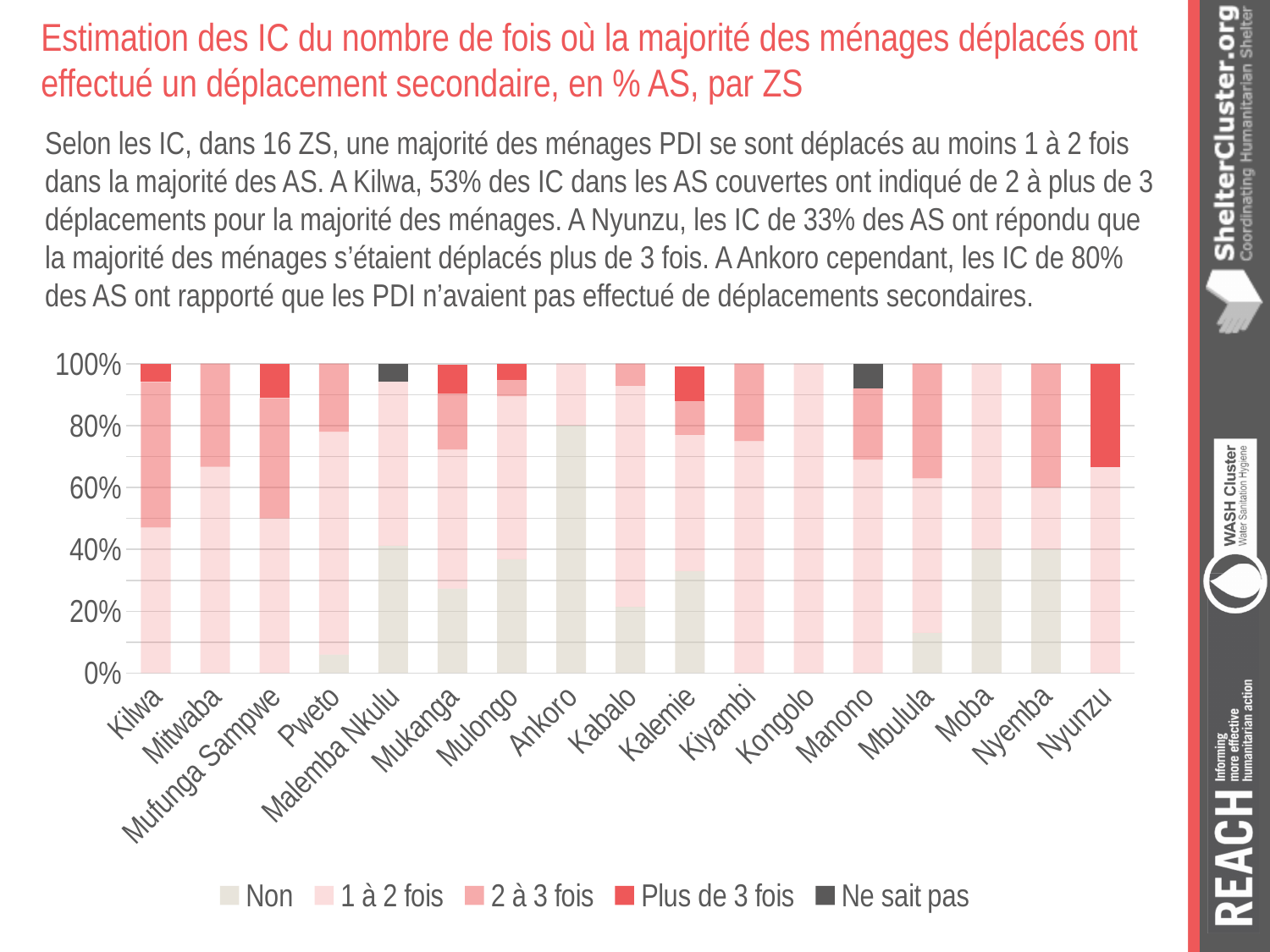
How many series does the chart legend list? 5 How many zones de santé (ZS) are shown on the x axis of the chart? 17 Is the 'Non' share for Kilwa greater or less than 40%? less Which is larger, the 'Non' share for Ankoro or the 'Non' share for Moba? Ankoro Which ZS has the largest 'Non' share in the chart? Ankoro Which ZS bars include a 'Ne sait pas' segment? Malemba Nkulu and Manono What is the total of the stacked bar for Kongolo? 100% Is the 'Non' share for Pweto greater or less than 20%? less Is the 'Non' share for Mbulula greater or less than 20%? less What is the 'Non' share for Ankoro? 80% Which ZS has the largest 'Plus de 3 fois' share? Nyunzu What kind of chart is shown on the slide? Stacked bar chart